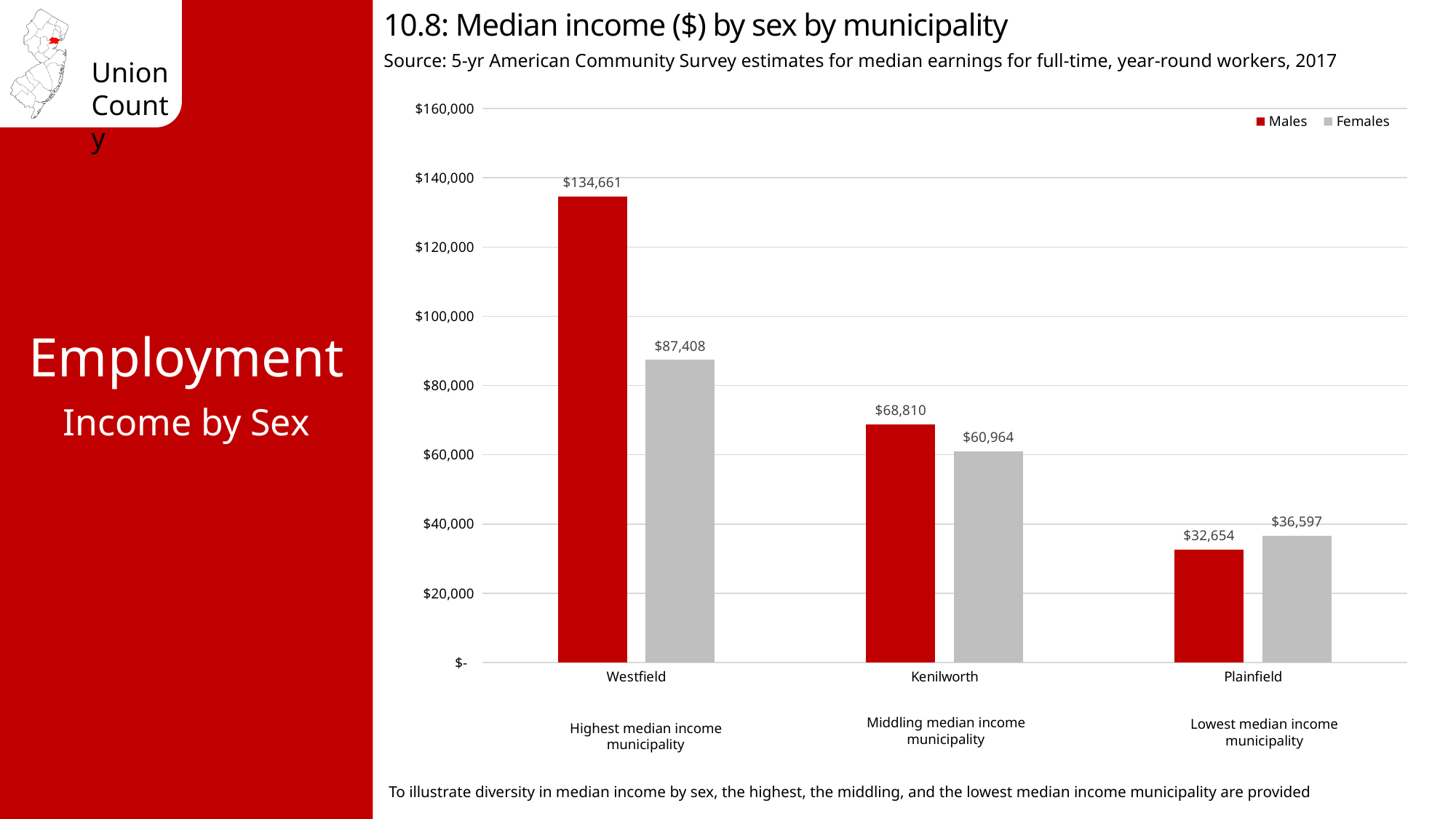
What is the difference between male and female median income in Kenilworth? $7,846 What is the median income for females in Kenilworth? $60,964 How many series does the legend list? 2 What is the median income for males in Westfield? $134,661 Which municipality has the lowest median income for females? Plainfield Is the median income for females in Westfield greater or less than $80,000? greater Which municipality has the highest median income for males? Westfield What is the difference between male and female median income in Westfield? $47,253 In Plainfield, which is larger: the median income for males or for females? Females How many municipalities are shown on the chart? 3 What kind of chart is shown on the slide? Bar chart What is the median income for females in Plainfield? $36,597